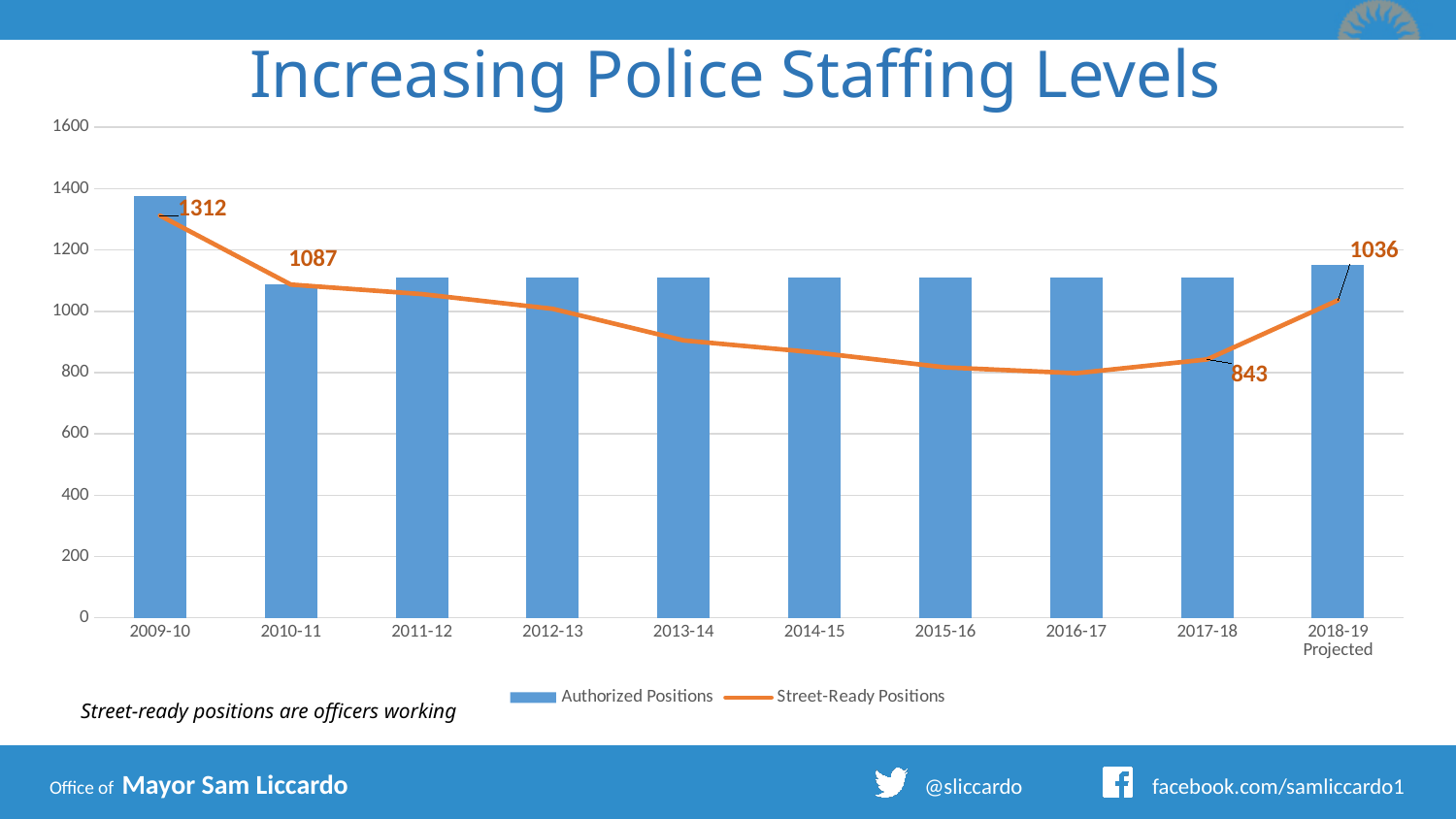
Is the Authorized Positions bar for 2015-16 greater or less than 1200? less Which is larger, the Authorized Positions bar for 2009-10 or for 2018-19 Projected? 2009-10 What is the Street-Ready Positions value for 2010-11? 1087 Is the Authorized Positions bar for 2009-10 greater or less than 1200? greater What is the Street-Ready Positions value for 2018-19 Projected? 1036 By how much did Street-Ready Positions fall from 2009-10 to 2010-11? 225 What is the Street-Ready Positions value for 2009-10? 1312 What is the Street-Ready Positions value for 2017-18? 843 How many years are shown on the x axis? 10 In which year is the Street-Ready Positions line at its highest? 2009-10 What is the difference between the Street-Ready Positions values for 2018-19 Projected and 2017-18? 193 How many series does the legend list? 2